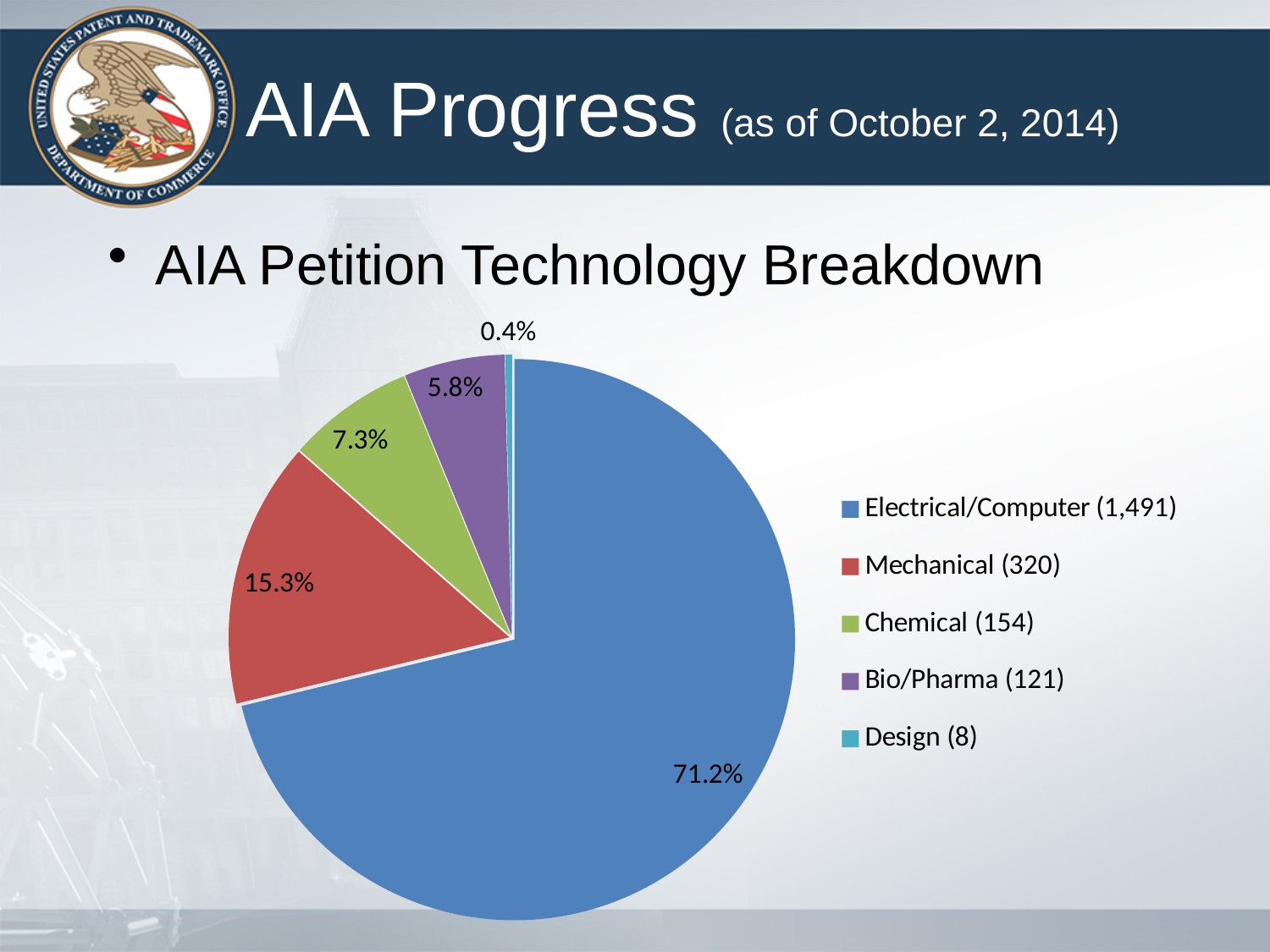
What is the difference in percentage points between the Mechanical and Chemical slices? 8.0 percentage points What share of the pie does Mechanical represent? 15.3% Which is larger, the Chemical slice or the Bio/Pharma slice? Chemical How many categories does the pie chart show? 5 What share of the pie does Bio/Pharma represent? 5.8% Which category has the smallest slice of the pie? Design What share of the pie does Electrical/Computer represent? 71.2% Which category has the largest slice of the pie? Electrical/Computer What kind of chart is shown on the slide? Pie chart What count is shown in the legend for Mechanical? 320